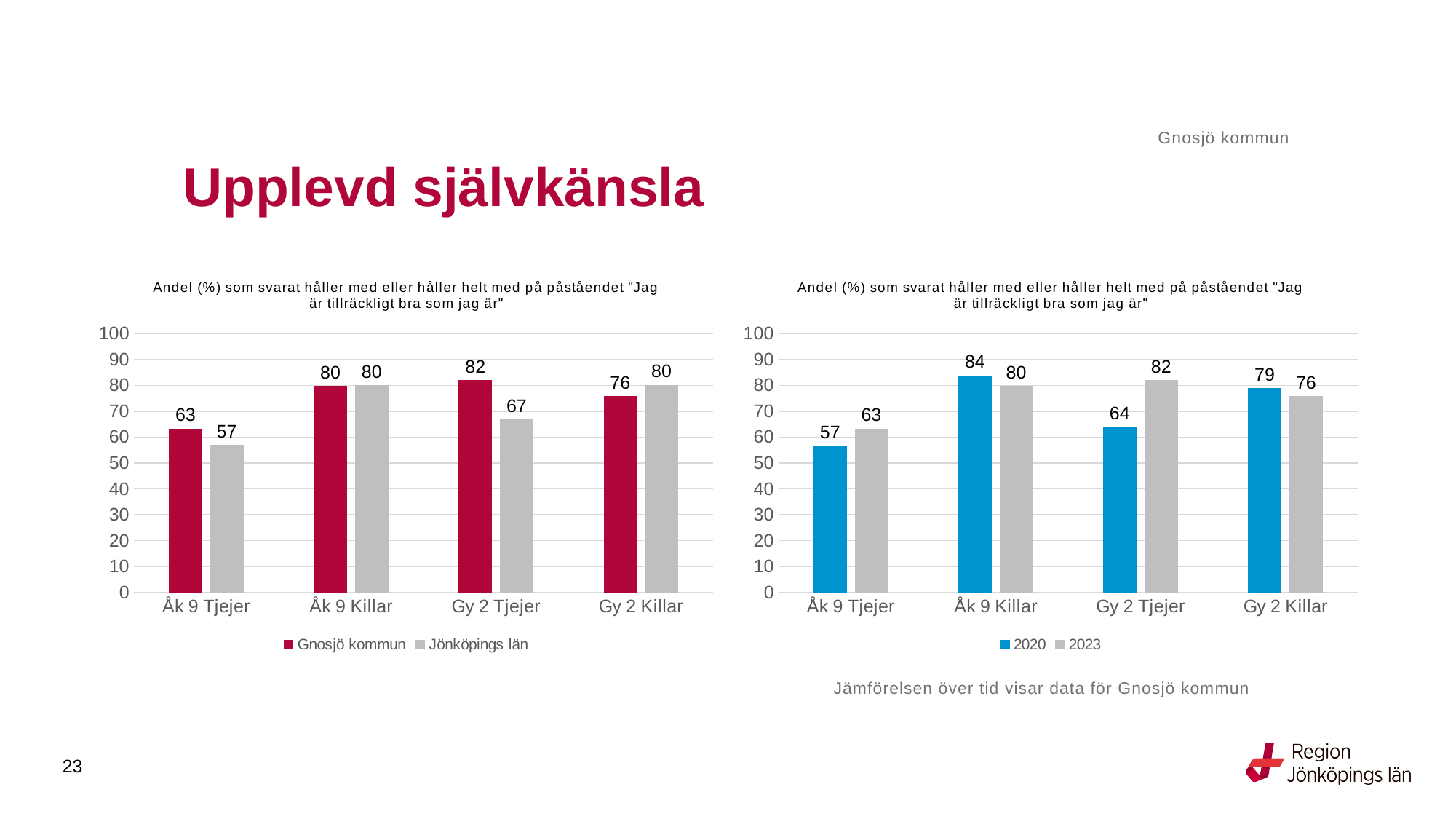
In the left chart, what is the value for Gnosjö kommun for Gy 2 Tjejer? 82 In the left chart, what is the difference between Gnosjö kommun and Jönköpings län for Gy 2 Tjejer? 15 In the right chart, which category has the highest value for 2020? Åk 9 Killar In the right chart, how many series does the legend list? 2 In the left chart, which is larger for Gy 2 Killar: Gnosjö kommun or Jönköpings län? Jönköpings län In the right chart, what is the difference between 2023 and 2020 for Gy 2 Tjejer? 18 In the right chart, what is the value for 2020 for Åk 9 Killar? 84 What type of chart is the right chart? Bar chart In the left chart, what is the value for Jönköpings län for Åk 9 Tjejer? 57 How many categories are shown on the x axis of the left chart? 4 In the left chart, which category has the lowest value for Gnosjö kommun? Åk 9 Tjejer In the right chart, what is the value for 2023 for Gy 2 Tjejer? 82